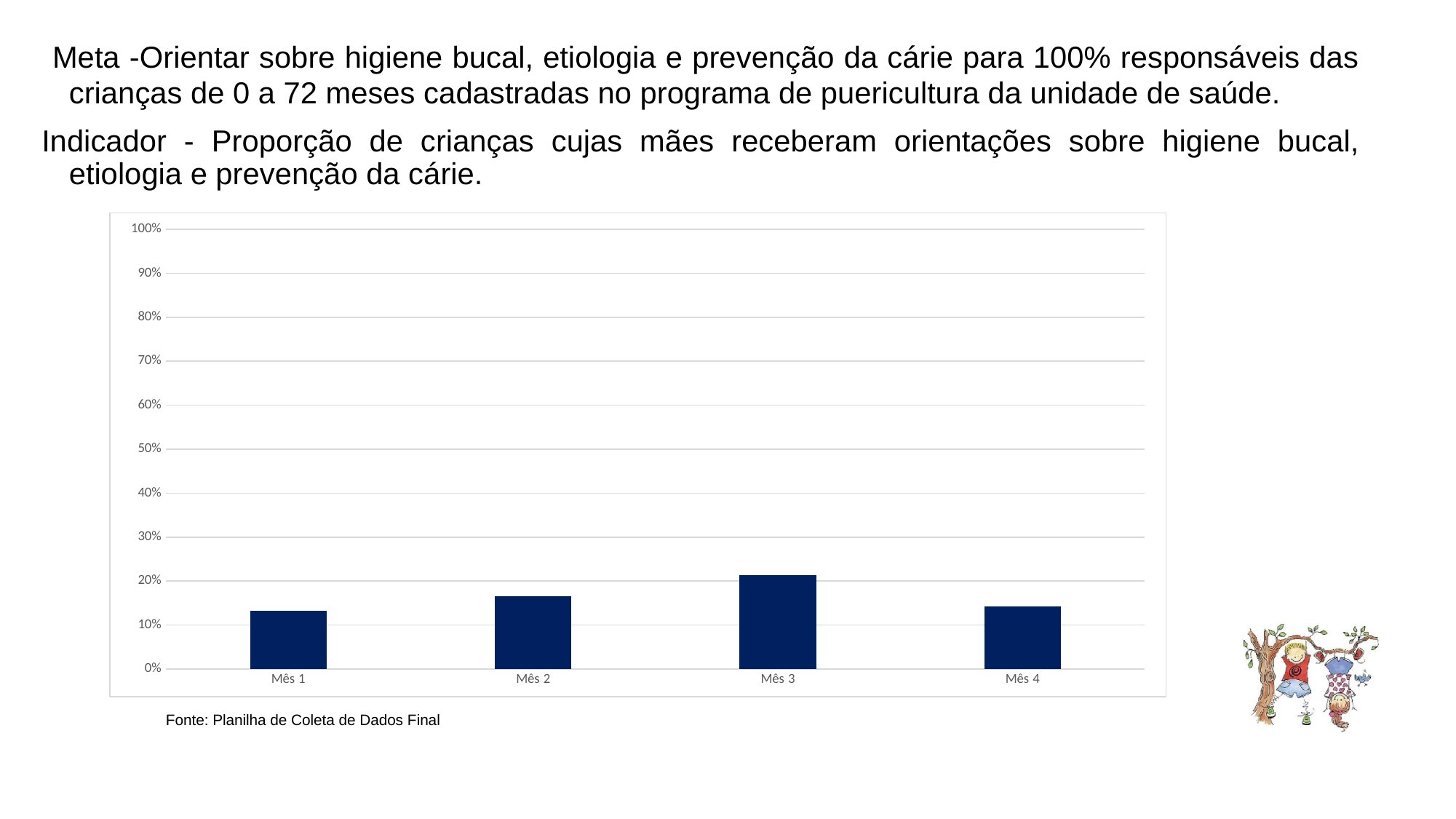
Is the value for Mês 1 greater or less than 10%? greater What is the highest value shown on the chart's y axis? 100% Do the values rise or fall from Mês 1 to Mês 3? rise Is the value for Mês 1 greater or less than 20%? less Is the value for Mês 3 greater or less than 30%? less Which month has the highest value in the chart? Mês 3 Which is larger, the value for Mês 2 or the value for Mês 1? Mês 2 How many months (categories) are shown on the x axis of the chart? 4 What kind of chart is shown on the slide? bar chart Which is larger, the value for Mês 3 or the value for Mês 1? Mês 3